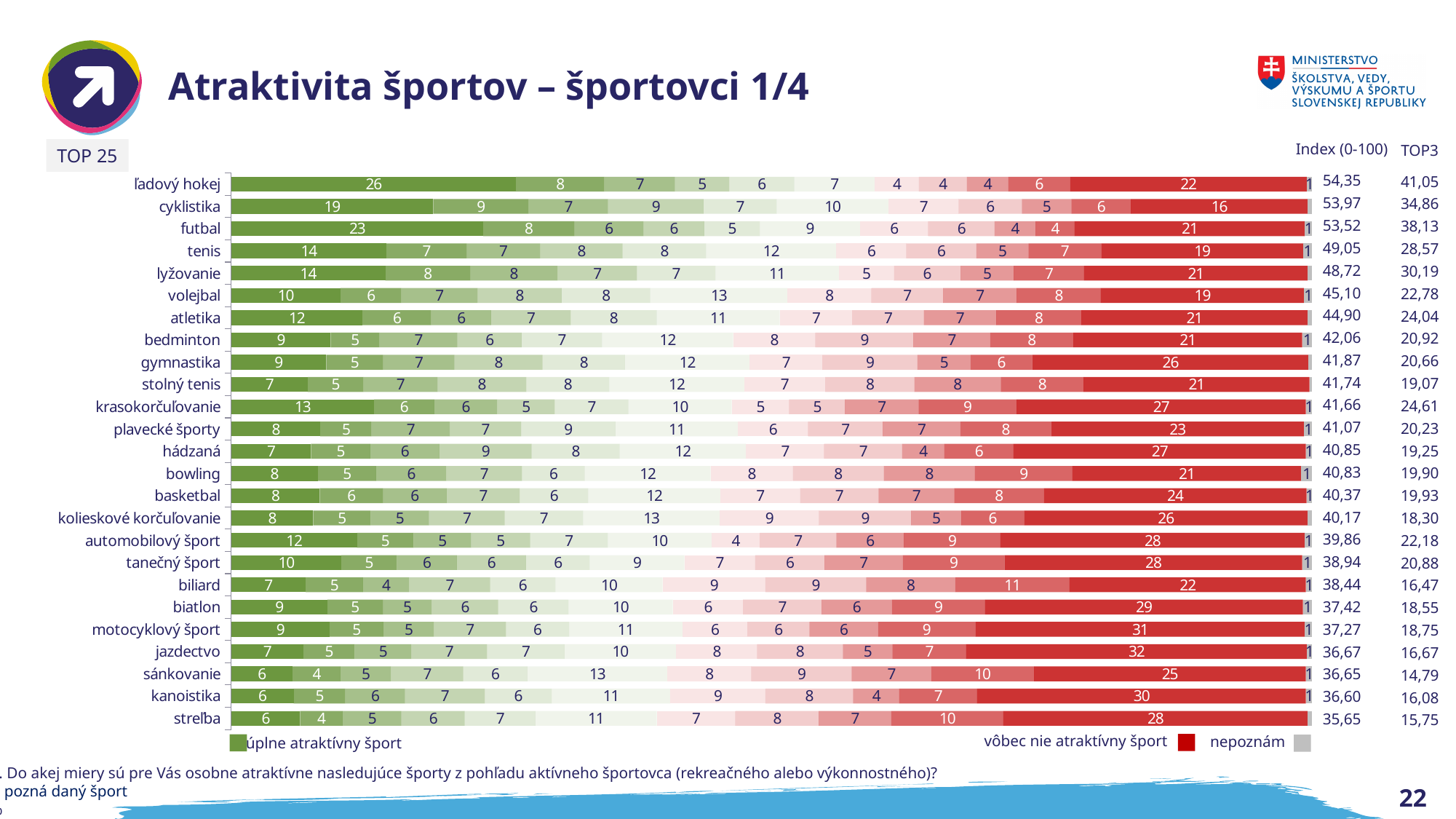
Which sport has the lowest Index (0-100) value? streľba What is the difference between the Index (0-100) values of ľadový hokej and cyklistika? 0,38 How many sports are listed in the chart? 25 Which sport has the largest 'úplne atraktívny šport' segment? ľadový hokej Which sport has the highest Index (0-100) value? ľadový hokej Which has a larger 'úplne atraktívny šport' segment, futbal or cyklistika? futbal What is the Index (0-100) value for cyklistika? 53,97 What is the TOP3 value for futbal? 38,13 What kind of chart is shown on the slide? bar chart What is the value of the 'vôbec nie atraktívny šport' segment for jazdectvo? 32 Which sport has the largest 'vôbec nie atraktívny šport' segment? jazdectvo What is the value of the 'úplne atraktívny šport' segment for ľadový hokej? 26